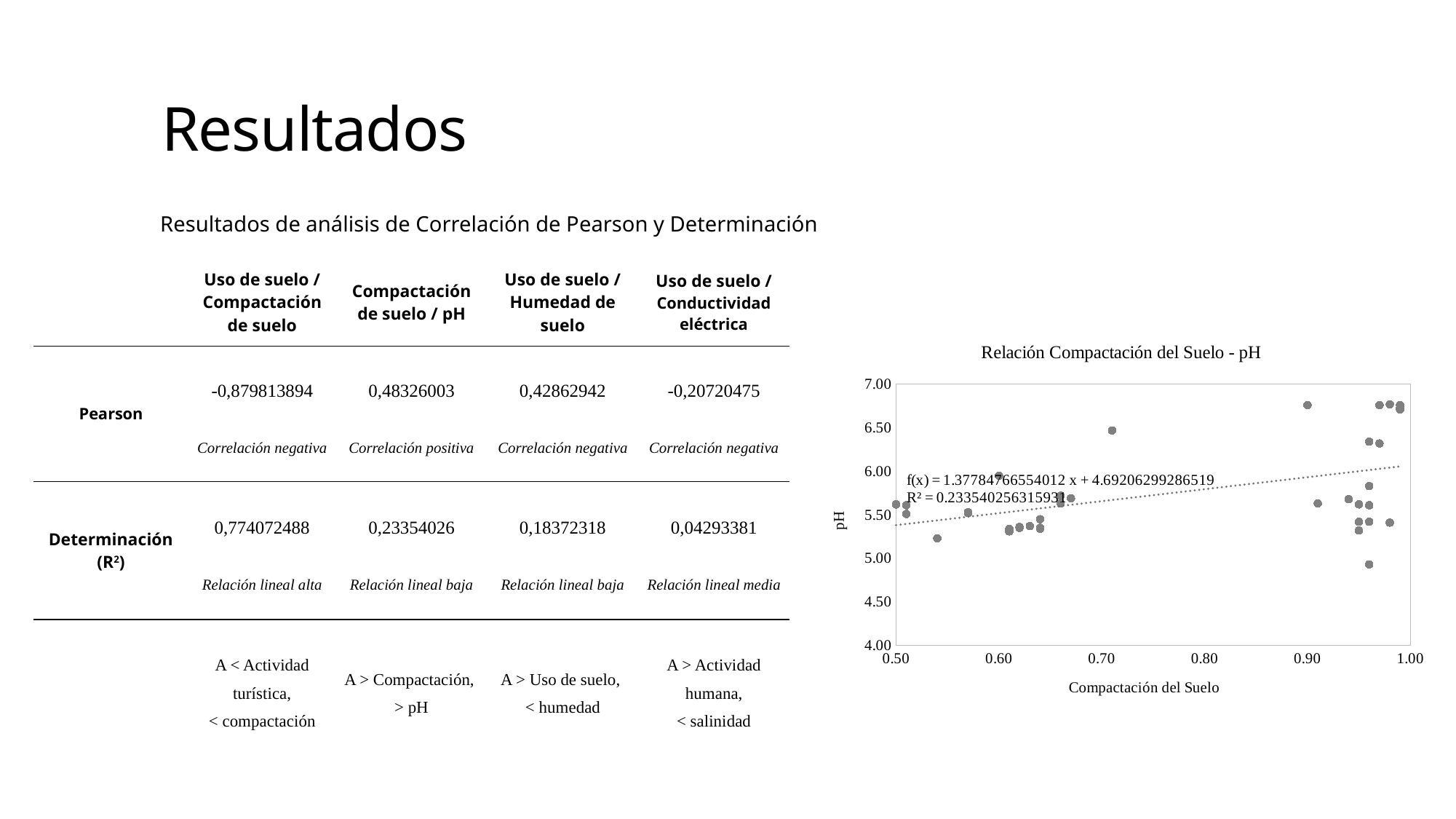
What is the label of the x axis of the chart? Compactación del Suelo Is the pH value of the point at Compactación del Suelo of about 0.54 greater or less than 5.50? less Is the pH value of the point at Compactación del Suelo of about 0.90 greater or less than 6.50? greater What R² value is printed on the chart? R² = 0.233540256315931 What is the title of the chart on the slide? Relación Compactación del Suelo - pH What is the trendline equation printed on the chart? f(x) = 1.37784766554012 x + 4.69206299286519 What is the highest tick value shown on the y axis of the chart? 7.00 Is the pH value of the point at Compactación del Suelo of about 0.71 greater or less than 6.00? greater What kind of chart is shown on the slide? scatter chart Does the trendline on the chart rise or fall as Compactación del Suelo increases? rise What is the lowest tick value shown on the x axis of the chart? 0.50